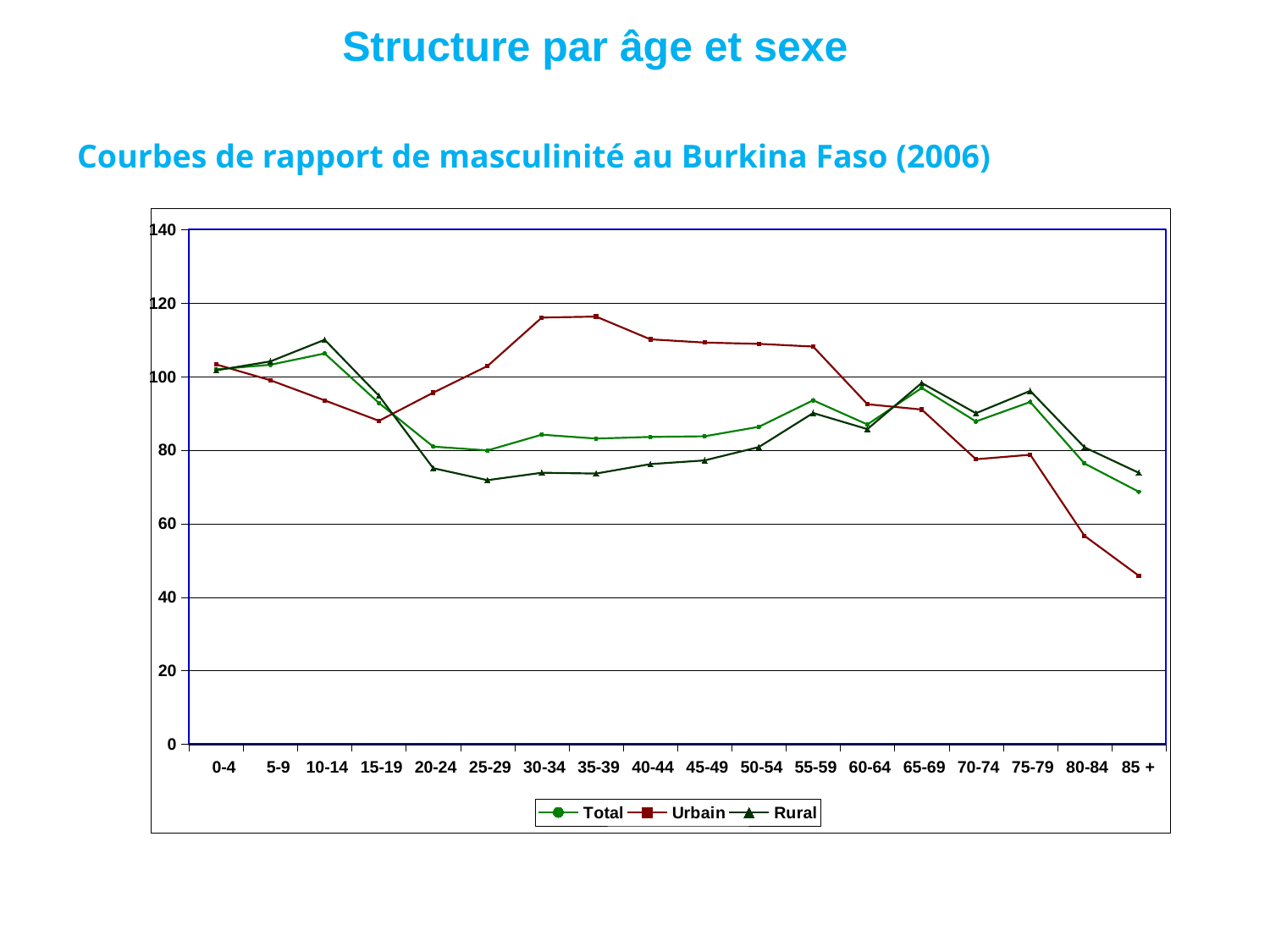
Is the Urbain value for the 30-34 age group greater or less than 100? greater What are the three series named in the legend? Total, Urbain, Rural For the 10-14 age group, which series has the larger value, Rural or Urbain? Rural How many age groups are shown on the x axis? 18 Is the Urbain value for the 85 + age group greater or less than 60? less What kind of chart is shown on the slide? line chart For which age group is the Urbain series at its lowest? 85 + Does the Urbain series rise or fall from the 55-59 age group to the 85 + age group? fall How many series does the legend list? 3 Is the Rural value for the 25-29 age group greater or less than 80? less For the 35-39 age group, which series has the larger value, Urbain or Rural? Urbain For which age group is the Rural series at its highest? 10-14